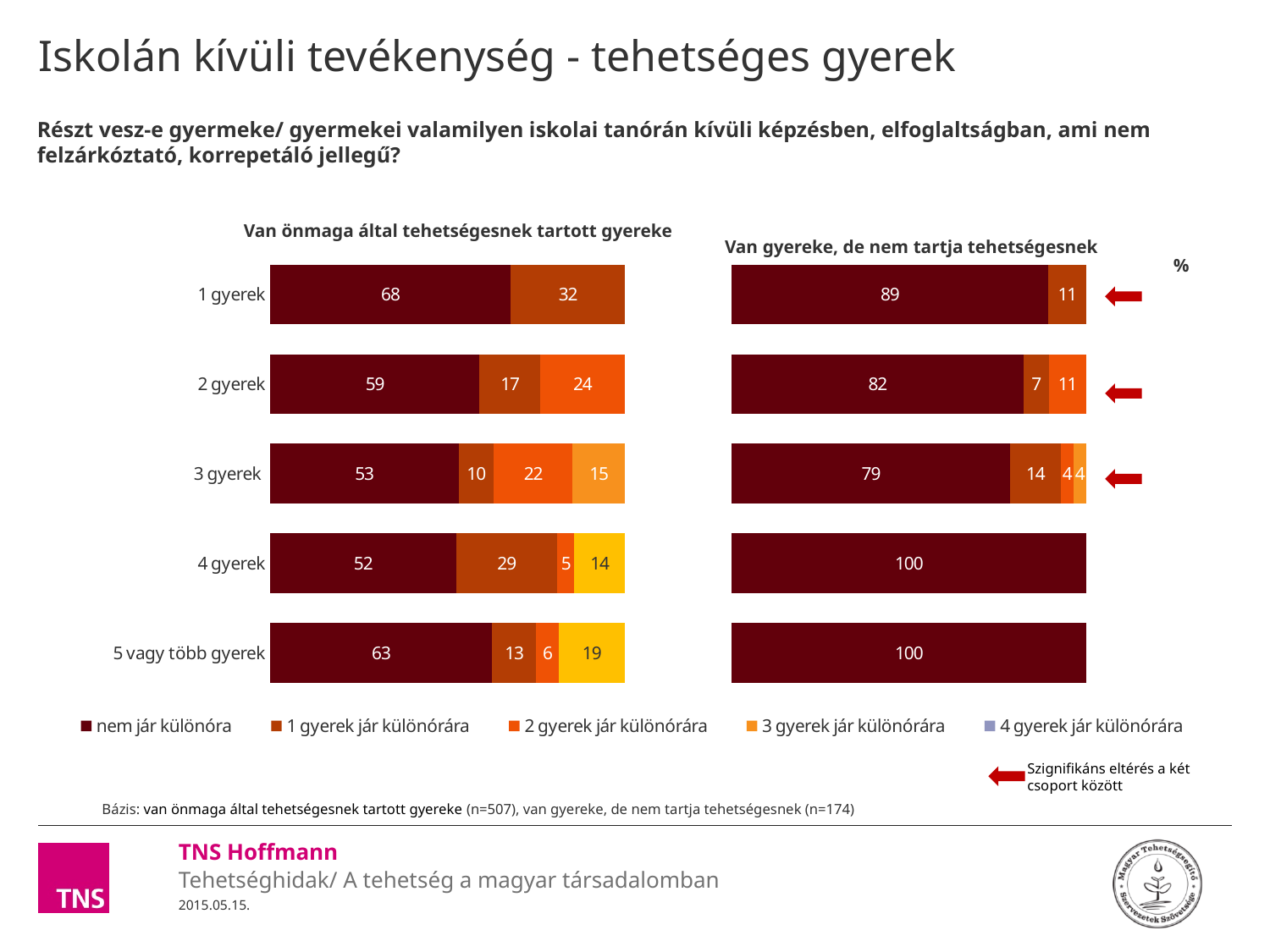
In the right chart (Van gyereke, de nem tartja tehetségesnek), what is the value of '1 gyerek jár különórára' for 2 gyerek? 7 What is the difference between the 'nem jár különóra' value for 1 gyerek in the right chart and in the left chart? 21 In the right chart (Van gyereke, de nem tartja tehetségesnek), what is the value of 'nem jár különóra' for 3 gyerek? 79 In the left chart (Van önmaga által tehetségesnek tartott gyereke), what is the value of '1 gyerek jár különórára' for 4 gyerek? 29 How many series does the legend list? 5 In the left chart (Van önmaga által tehetségesnek tartott gyereke), is the 'nem jár különóra' value larger for 2 gyerek or for 5 vagy több gyerek? 5 vagy több gyerek What kind of chart is used on this slide? Stacked bar chart How many categories are shown on the y axis of the left chart (Van önmaga által tehetségesnek tartott gyereke)? 5 In the right chart (Van gyereke, de nem tartja tehetségesnek), which categories have a 'nem jár különóra' value of 100? 4 gyerek and 5 vagy több gyerek In the left chart (Van önmaga által tehetségesnek tartott gyereke), what is the value of 'nem jár különóra' for 1 gyerek? 68 In the left chart (Van önmaga által tehetségesnek tartott gyereke), which category has the lowest 'nem jár különóra' value? 4 gyerek What is the title of the right chart? Van gyereke, de nem tartja tehetségesnek